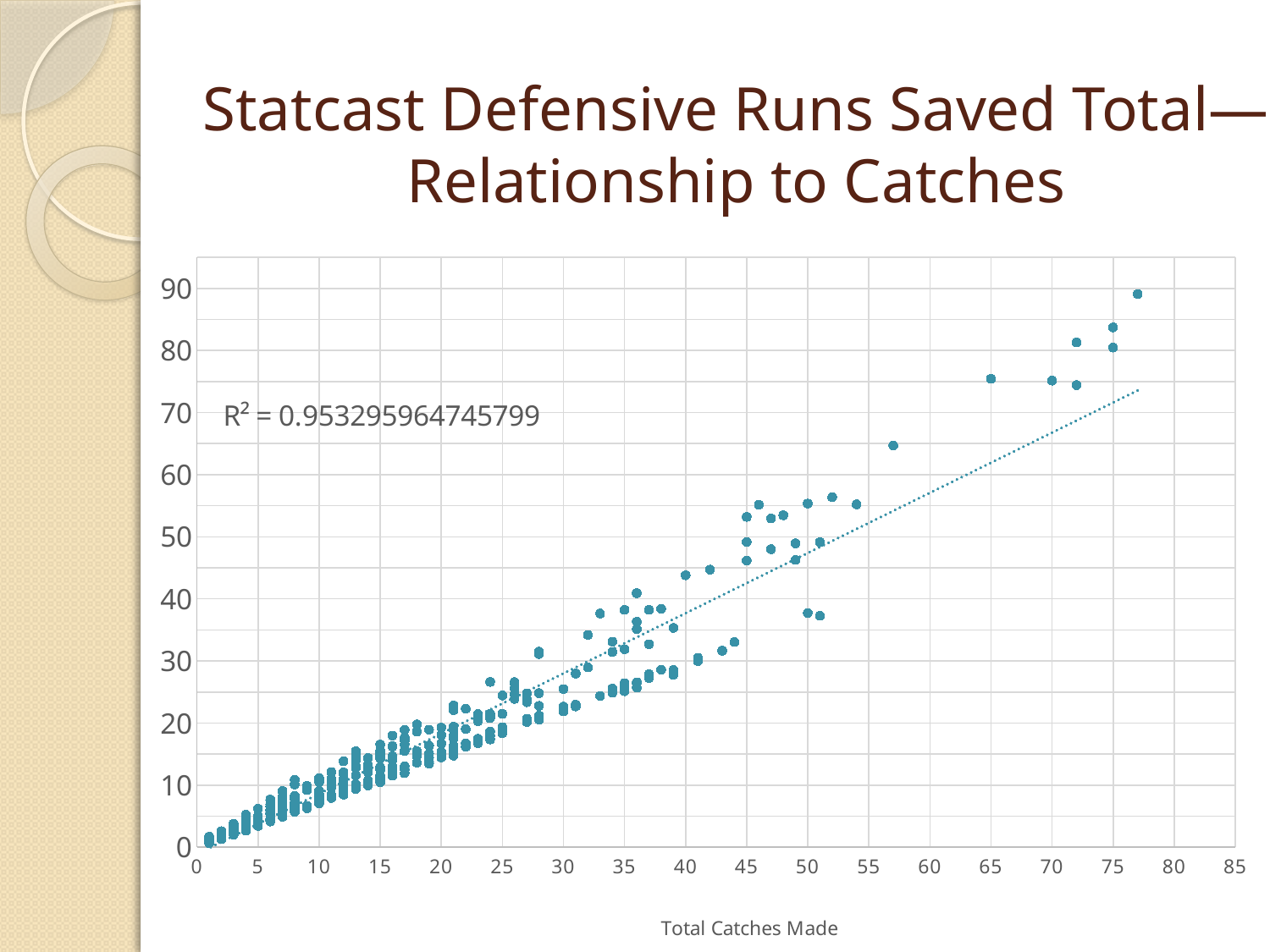
Are the points at 30 catches greater or less than 30? less Is the value of the highest point on the chart (at about 77 catches) greater or less than 80? greater Is the value of the point at 57 catches greater or less than 60? greater What is the title of the horizontal axis? Total Catches Made What R² value is printed on the chart? R² = 0.953295964745799 What kind of chart is shown on the slide? scatter chart Do the plotted values generally rise or fall as Total Catches Made increases? rise